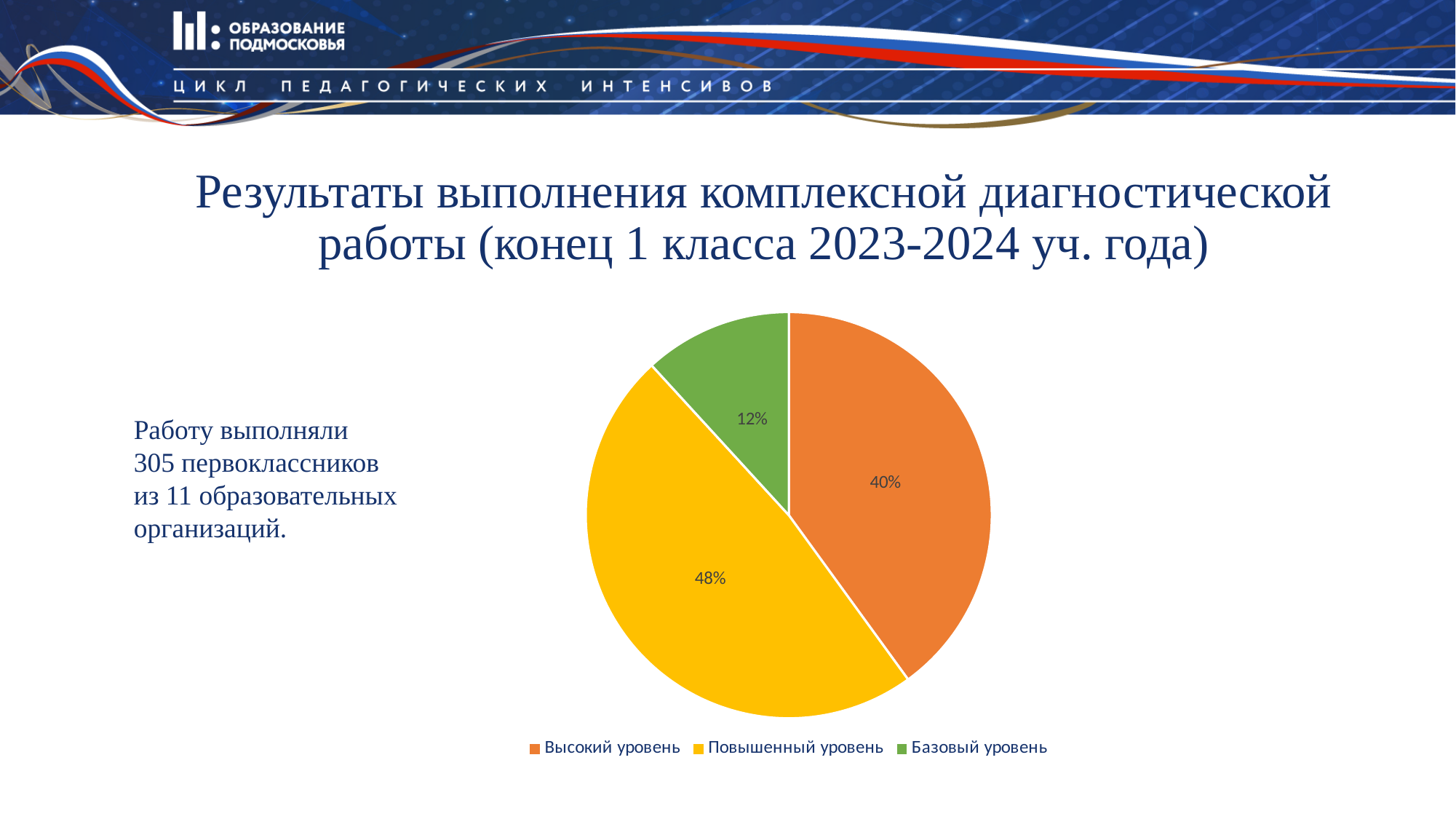
What share of the pie does Повышенный уровень have? 48% Which is larger: the share for Высокий уровень or for Базовый уровень? Высокий уровень What share of the pie does Базовый уровень have? 12% What kind of chart is shown on the slide? Pie chart Which level has the largest slice of the pie? Повышенный уровень What colour is the slice for Базовый уровень? Green How many entries does the legend list? 3 What share of the pie does Высокий уровень have? 40% How many slices does the pie chart have? 3 What is the difference in percentage points between Высокий уровень and Базовый уровень? 28 Which level has the smallest slice of the pie? Базовый уровень What is the difference in percentage points between Повышенный уровень and Высокий уровень? 8